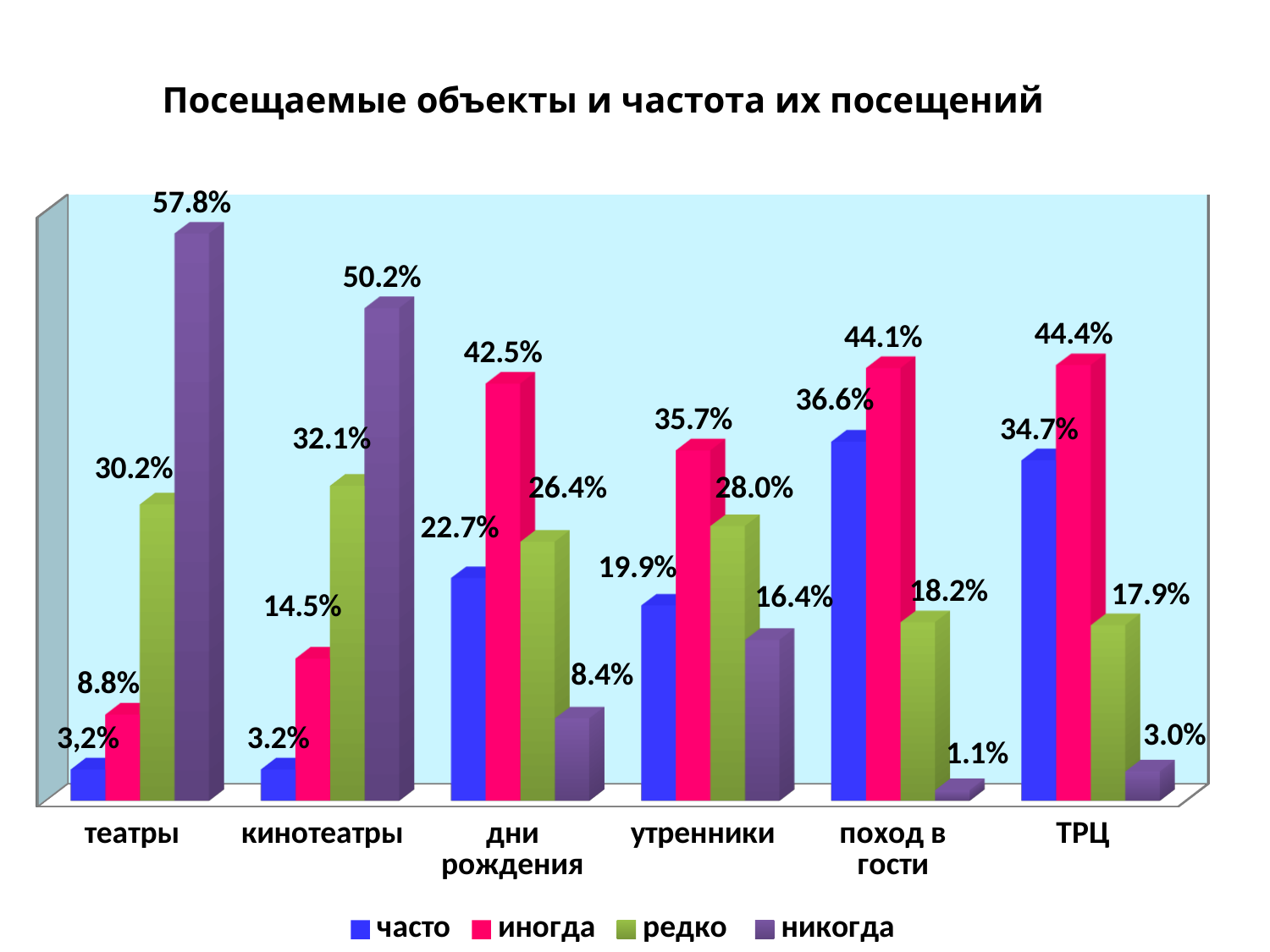
What is the title of the chart? Посещаемые объекты и частота их посещений How many series does the legend list? 4 What is the difference between the "никогда" values for "театры" and "кинотеатры"? 7.6% What is the value for "часто" in the "поход в гости" category? 36.6% What is the value for "никогда" in the "театры" category? 57.8% How many categories are shown on the x axis? 6 Which category has the lowest value for the "никогда" series? поход в гости What is the value for "иногда" in the "дни рождения" category? 42.5% Which is larger: the "часто" value for "поход в гости" or for "ТРЦ"? поход в гости What kind of chart is shown on the slide? bar chart Which category has the highest value for the "никогда" series? театры What is the value for "редко" in the "ТРЦ" category? 17.9%